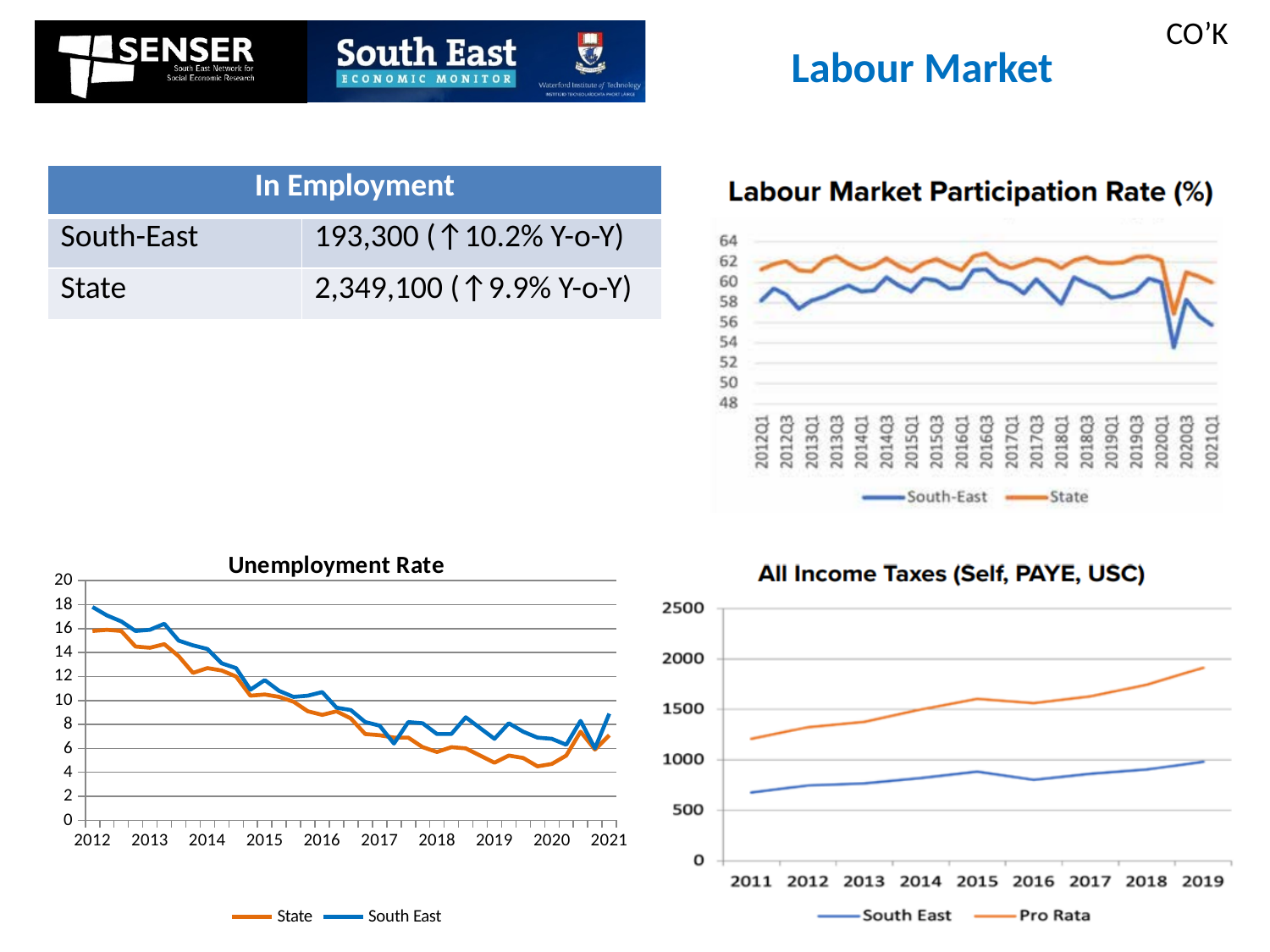
In the Labour Market Participation Rate (%) chart, which two series are shown in the legend? South-East and State In the Unemployment Rate chart, which series is higher at the start of 2012, State or South East? South East What kind of chart is the Unemployment Rate chart? Line chart How many years are labelled on the x axis of the All Income Taxes (Self, PAYE, USC) chart? 9 In the Labour Market Participation Rate (%) chart, is the lowest South-East value greater or less than 56? less How many series does the legend of the Unemployment Rate chart list? 2 In the Unemployment Rate chart, is the South East value at the start of 2012 greater or less than 16? greater In the All Income Taxes (Self, PAYE, USC) chart, do the Pro Rata values rise or fall from 2011 to 2019? Rise What kind of chart is the All Income Taxes (Self, PAYE, USC) chart? Line chart In the Unemployment Rate chart, do the values generally rise or fall from 2012 to 2020? Fall In the Labour Market Participation Rate (%) chart, which series is generally higher, South-East or State? State In the All Income Taxes (Self, PAYE, USC) chart, is the Pro Rata value in 2019 greater or less than 1500? greater